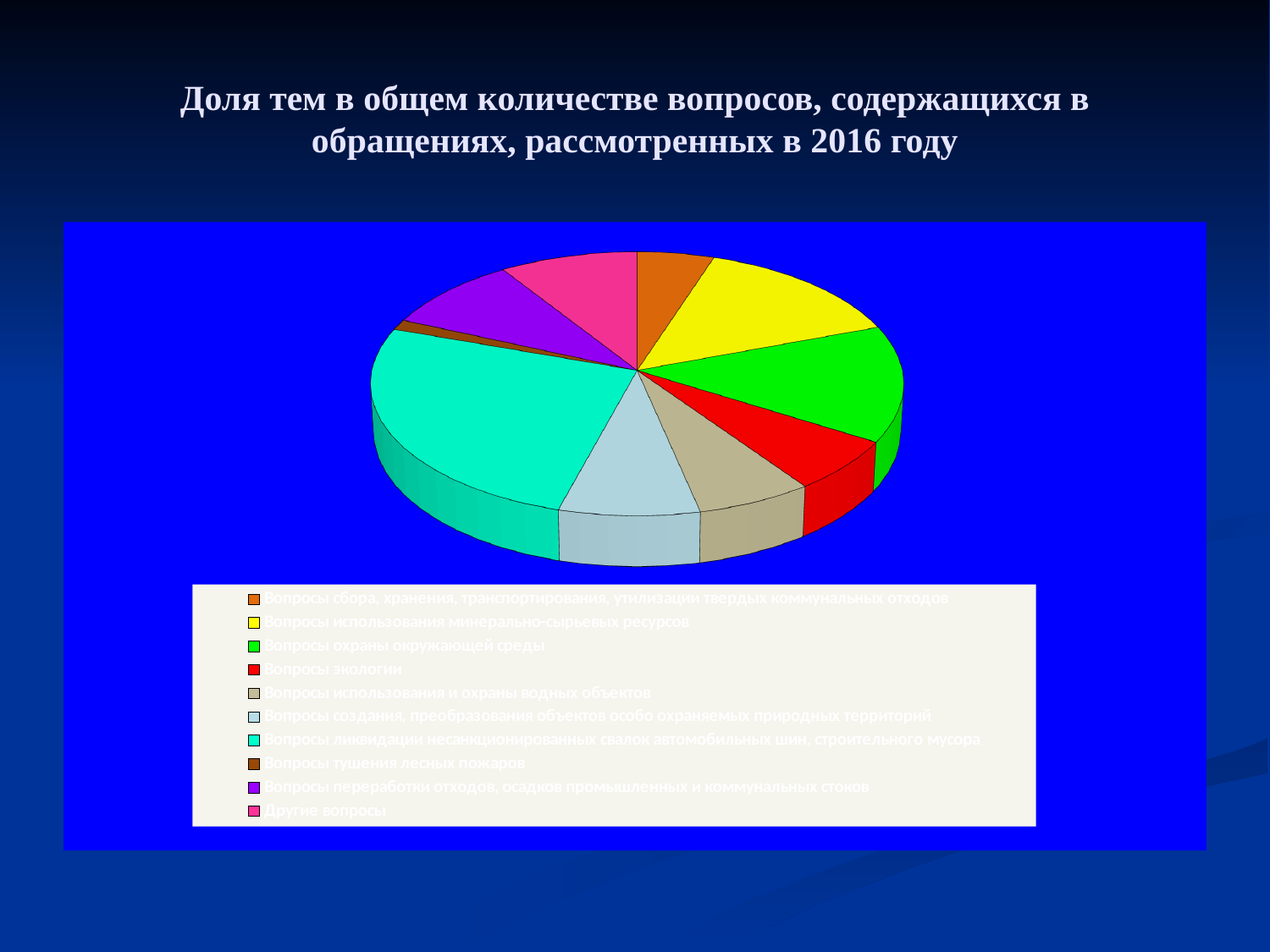
Which category has the largest share of the pie? Вопросы ликвидации несанкционированных свалок автомобильных шин, строительного мусора Which has the larger share: Вопросы охраны окружающей среды or Вопросы тушения лесных пожаров? Вопросы охраны окружающей среды What is the title of the slide? Доля тем в общем количестве вопросов, содержащихся в обращениях, рассмотренных в 2016 году What colour represents Вопросы экологии in the pie chart? red Which has the larger share: Вопросы использования минерально-сырьевых ресурсов or Вопросы сбора, хранения, транспортирования, утилизации твердых коммунальных отходов? Вопросы использования минерально-сырьевых ресурсов What kind of chart is shown on the slide? pie chart Which has the larger share: Вопросы переработки отходов, осадков промышленных и коммунальных стоков or Вопросы тушения лесных пожаров? Вопросы переработки отходов, осадков промышленных и коммунальных стоков Which category has the smallest share of the pie? Вопросы тушения лесных пожаров How many categories (slices) does the pie chart have? 10